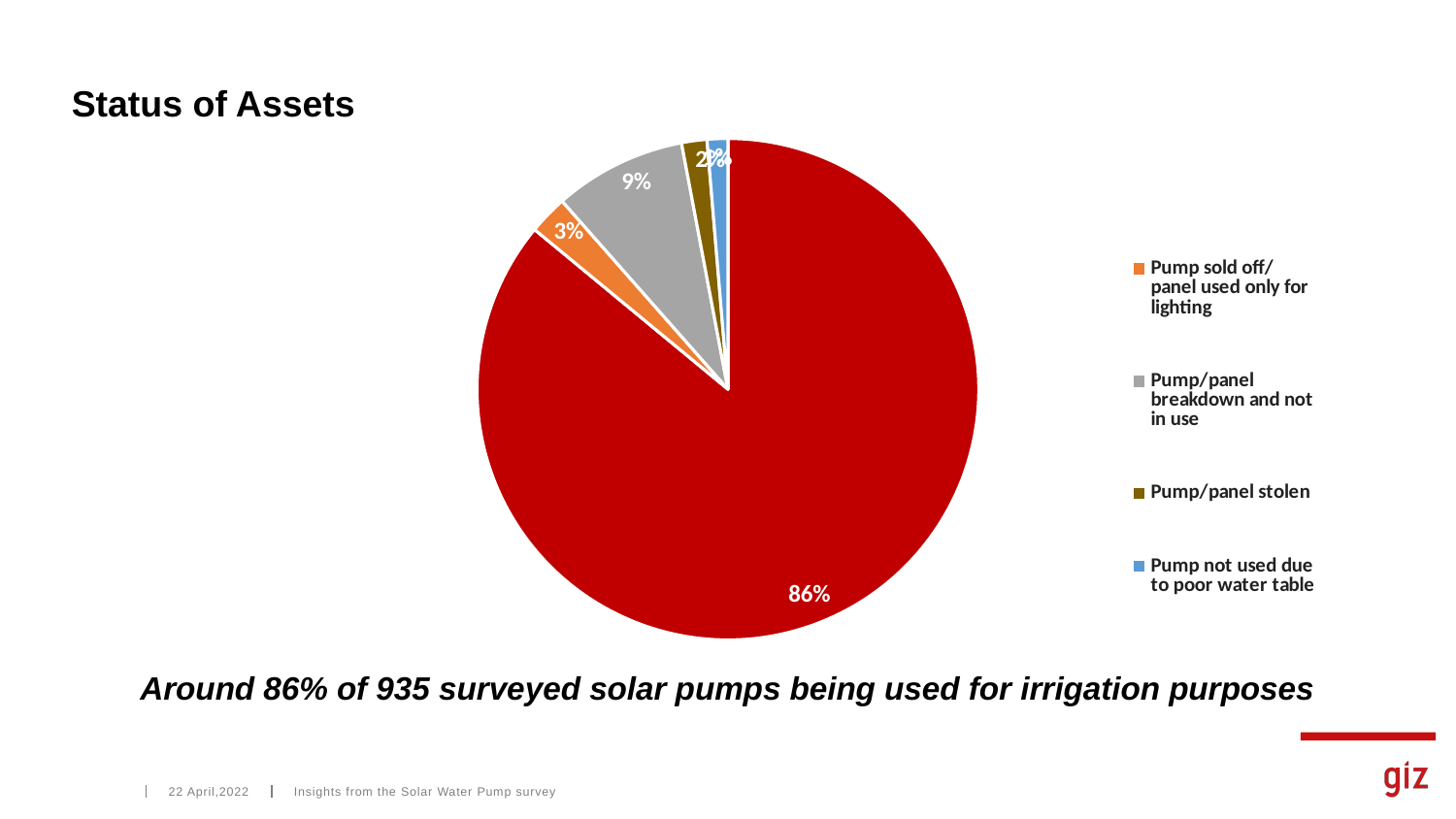
What percentage of the pie is labelled for 'Pump/panel stolen'? 2% Which of the legend categories has the smallest slice of the pie? Pump not used due to poor water table Which slice is larger: 'Pump/panel breakdown and not in use' or 'Pump sold off/ panel used only for lighting'? Pump/panel breakdown and not in use What colour is the 'Pump/panel breakdown and not in use' slice? Gray What type of chart is shown on the slide? Pie chart What percentage of the pie is labelled for 'Pump sold off/ panel used only for lighting'? 3% How many entries does the legend of the pie chart list? 4 How many slices does the pie chart have? 5 What is the title of the chart on the slide? Status of Assets What percentage of the pie is labelled for 'Pump/panel breakdown and not in use'? 9% What is the difference in percentage points between the 'Pump/panel breakdown and not in use' slice and the 'Pump sold off/ panel used only for lighting' slice? 6 percentage points What is the largest percentage label shown on the pie chart? 86%